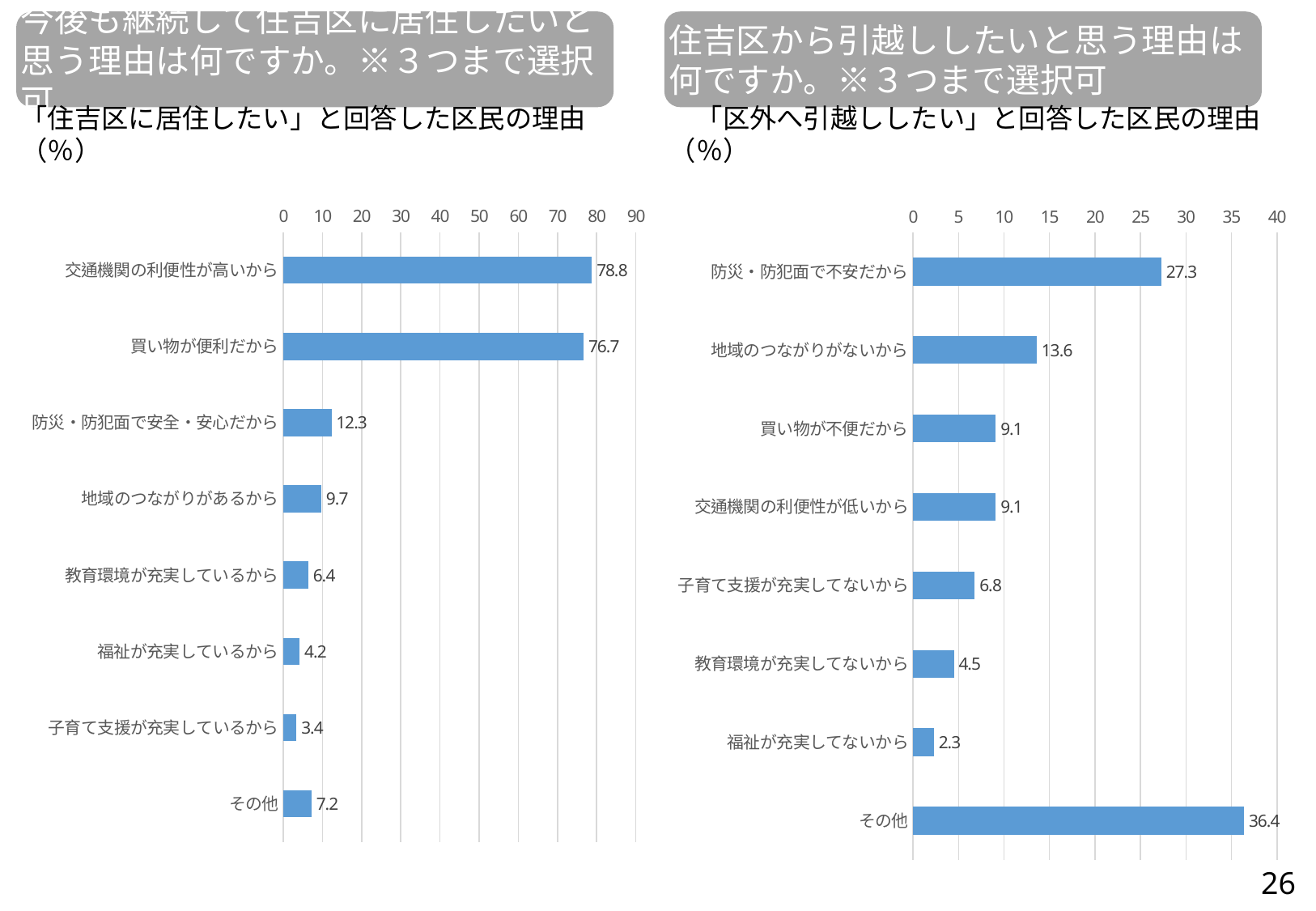
In the left chart (「住吉区に居住したい」と回答した区民の理由), what is the difference between 交通機関の利便性が高いから and 買い物が便利だから? 2.1 In the left chart (「住吉区に居住したい」と回答した区民の理由), which category has the lowest value? 子育て支援が充実しているから In the right chart (「区外へ引越ししたい」と回答した区民の理由), what is the value for 防災・防犯面で不安だから? 27.3 In the right chart (「区外へ引越ししたい」と回答した区民の理由), what is the value for 教育環境が充実してないから? 4.5 In the left chart (「住吉区に居住したい」と回答した区民の理由), how many categories are shown? 8 In the left chart (「住吉区に居住したい」と回答した区民の理由), what is the value for 地域のつながりがあるから? 9.7 What kind of chart is the left chart (「住吉区に居住したい」と回答した区民の理由)? Bar chart In the right chart (「区外へ引越ししたい」と回答した区民の理由), which is larger: 地域のつながりがないから or 子育て支援が充実してないから? 地域のつながりがないから In the left chart (「住吉区に居住したい」と回答した区民の理由), what is the value for 交通機関の利便性が高いから? 78.8 In the right chart (「区外へ引越ししたい」と回答した区民の理由), what is the difference between その他 and 防災・防犯面で不安だから? 9.1 In the right chart (「区外へ引越ししたい」と回答した区民の理由), which category has the highest value? その他 In the right chart (「区外へ引越ししたい」と回答した区民の理由), which category has the lowest value? 福祉が充実してないから